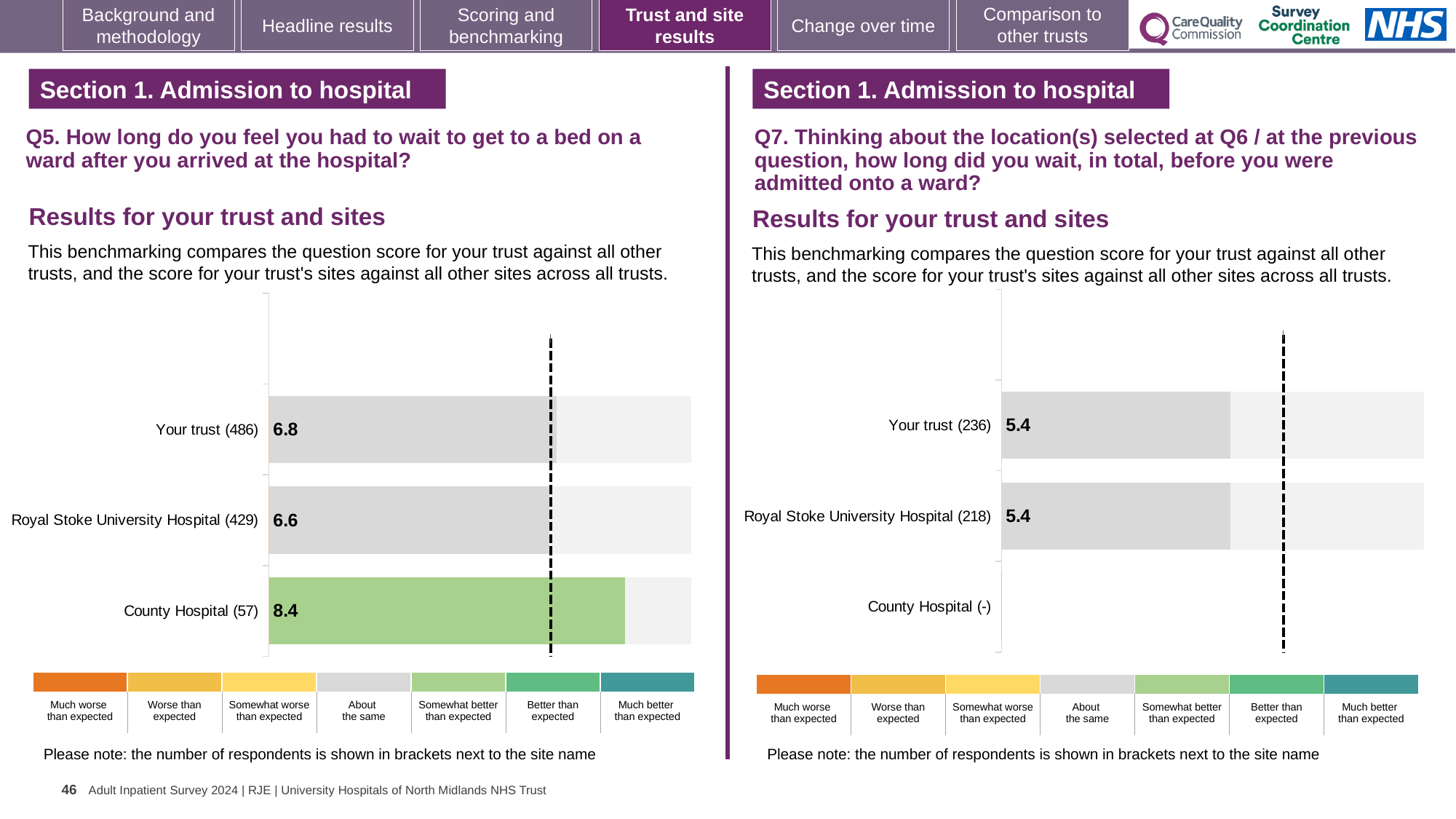
On the Q7 chart (right), how many respondents are shown for Royal Stoke University Hospital? 218 On the Q5 chart (left), which site or trust has the lowest score? Royal Stoke University Hospital (429) On the Q5 chart (left), which has the larger score: Your trust or Royal Stoke University Hospital? Your trust On the Q5 chart (left), what is the score for Royal Stoke University Hospital (429)? 6.6 What kind of chart is used on the Q5 chart (left)? Bar chart On the Q7 chart (right), what is the score for Royal Stoke University Hospital (218)? 5.4 On the Q5 chart (left), what is the difference between the County Hospital score and the Your trust score? 1.6 How many bars (rows) are plotted on the Q5 chart (left)? 3 On the Q5 chart (left), what is the score for Your trust (486)? 6.8 On the Q5 chart (left), what is the score for County Hospital (57)? 8.4 On the Q7 chart (right), what is the score for Your trust (236)? 5.4 On the Q5 chart (left), which site or trust has the highest score? County Hospital (57)